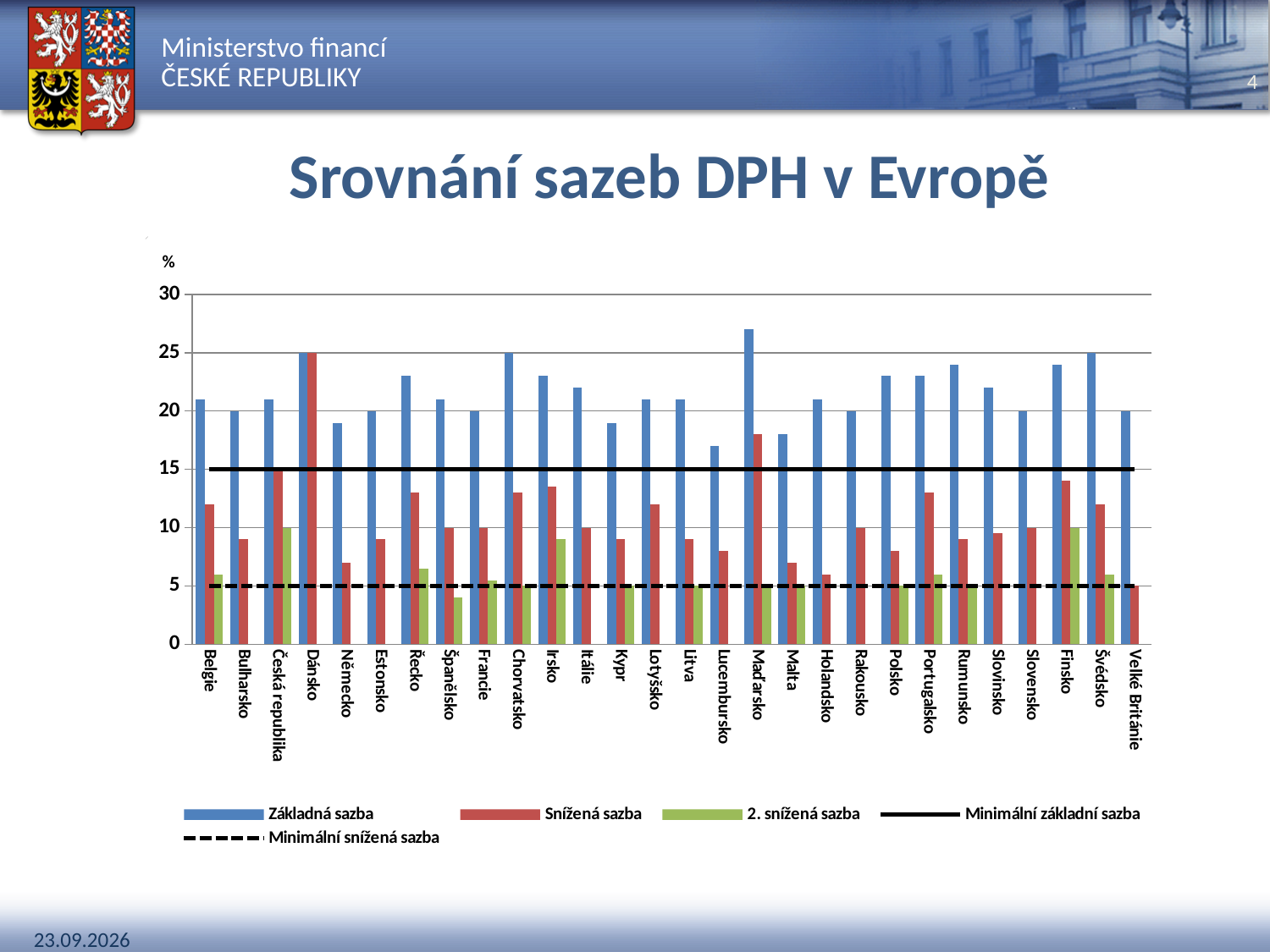
What is the Základná sazba for Dánsko? 25 At what level is the Minimální snížená sazba line drawn? 5 Which country has the lowest Základná sazba? Lucembursko At what level is the Minimální základní sazba line drawn? 15 What type of chart is shown on the slide? bar chart How many countries are shown on the x axis? 28 How many series does the legend list? 5 Is the Základná sazba for Maďarsko greater or less than 25? greater Which is larger, the Snížená sazba for Finsko or for Polsko? Finsko Is the Snížená sazba for Belgie greater or less than 10? greater Which country has the highest Základná sazba? Maďarsko What is the title of the chart? Srovnání sazeb DPH v Evropě